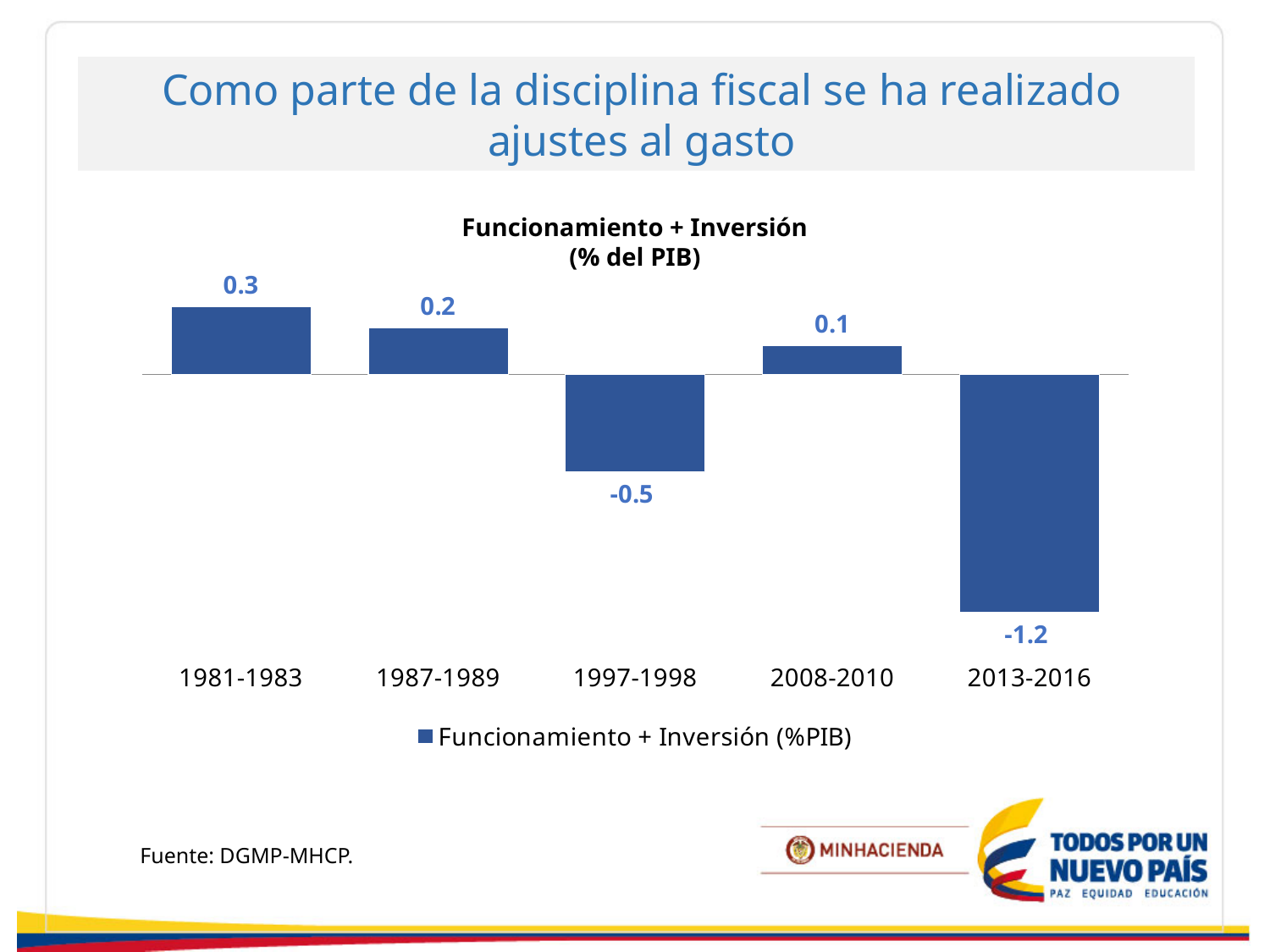
What is the difference between the values for 1997-1998 and 2013-2016? 0.7 What is the difference between the values for 1981-1983 and 1987-1989? 0.1 What is the value for 2008-2010? 0.1 What is the title of the chart? Funcionamiento + Inversión (% del PIB) What is the value for 1997-1998? -0.5 Which period has the highest value? 1981-1983 Which period has the lowest value? 2013-2016 Which is larger, the value for 1987-1989 or the value for 2008-2010? 1987-1989 How many periods are shown on the x axis? 5 What kind of chart is shown? Bar chart What is the value for 2013-2016? -1.2 What is the value for 1981-1983? 0.3